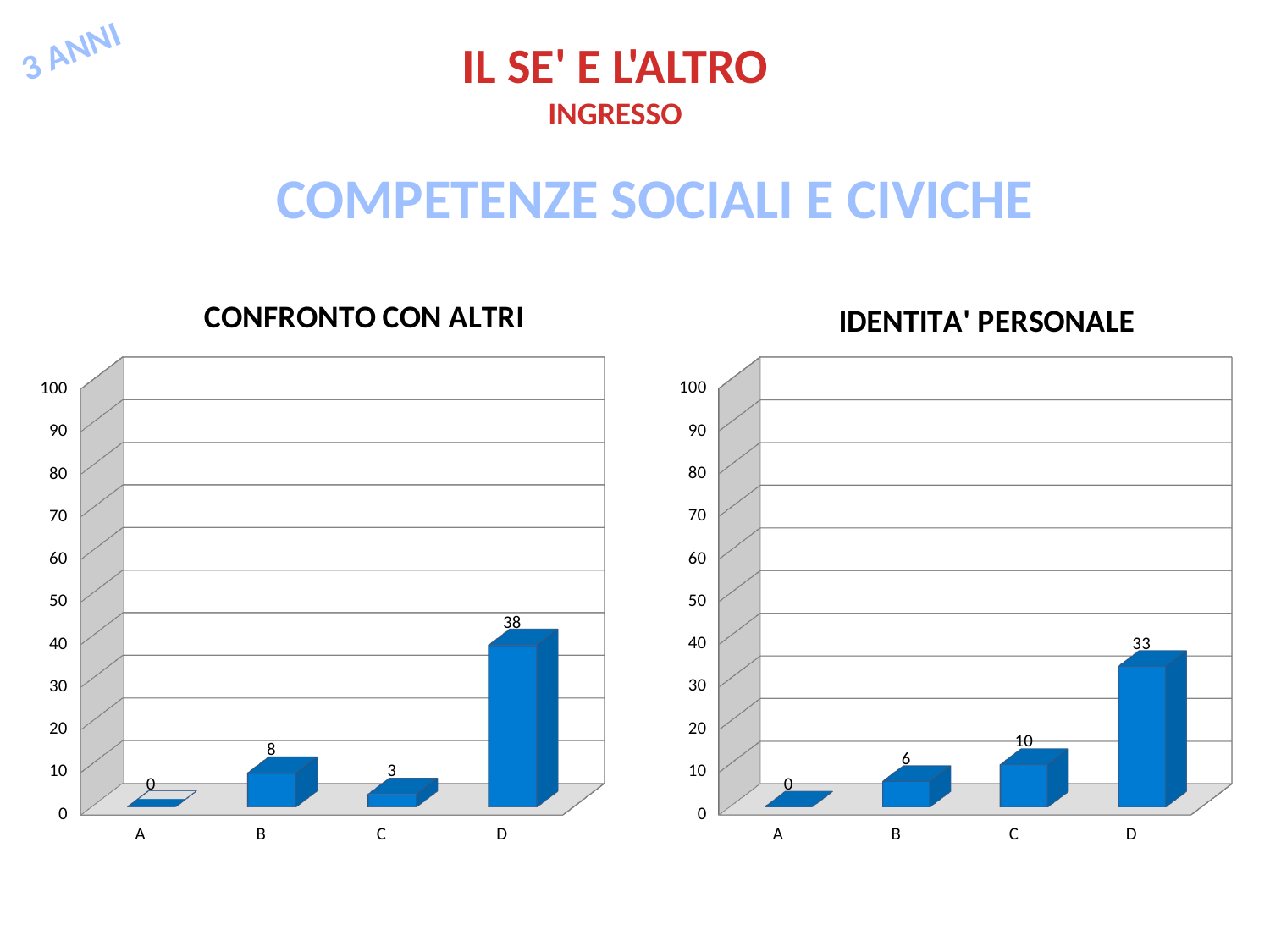
In the IDENTITA' PERSONALE chart, what is the value for C? 10 In the CONFRONTO CON ALTRI chart, what is the difference between the values for D and B? 30 What is the title of the chart on the right side of the slide? IDENTITA' PERSONALE In the CONFRONTO CON ALTRI chart, what is the value for B? 8 In the IDENTITA' PERSONALE chart, is the value for D greater or less than 40? less In the IDENTITA' PERSONALE chart, what is the difference between the values for D and C? 23 In the CONFRONTO CON ALTRI chart, which category has the lowest value? A In the CONFRONTO CON ALTRI chart, what is the value for D? 38 How many categories are shown in the CONFRONTO CON ALTRI chart? 4 What kind of chart is the IDENTITA' PERSONALE chart? bar chart In the IDENTITA' PERSONALE chart, which category has the highest value? D In the CONFRONTO CON ALTRI chart, which is larger, the value for B or the value for C? B